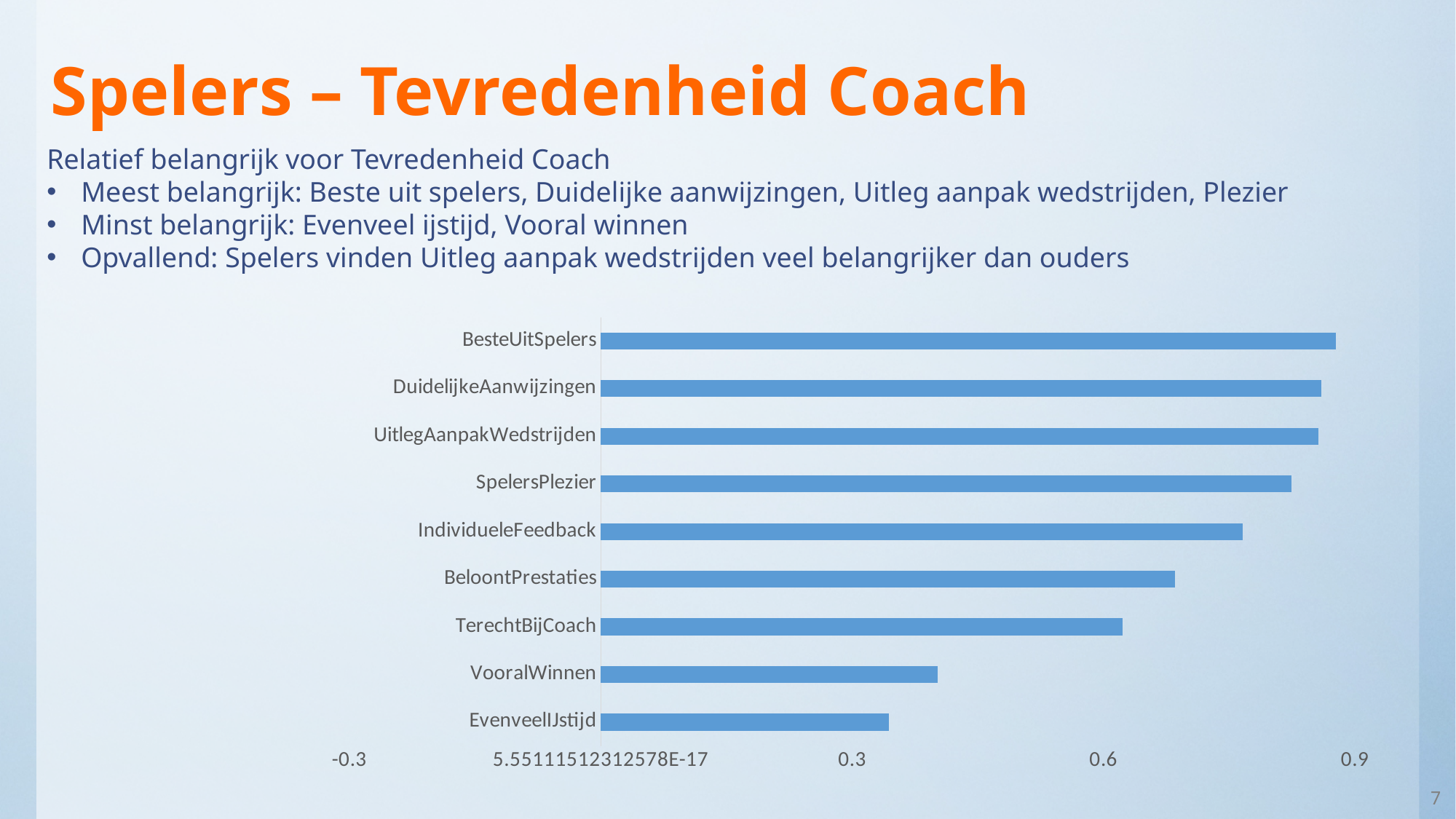
Is the value for BeloontPrestaties greater or less than 0.9? less Which category has the highest value in the bar chart? BesteUitSpelers Which category has the lowest value in the bar chart? EvenveelIJstijd Which is larger, the value for SpelersPlezier or the value for IndividueleFeedback? SpelersPlezier How many categories are plotted in the bar chart? 9 Is the value for EvenveelIJstijd greater or less than 0.3? greater Is the value for IndividueleFeedback greater or less than 0.6? greater What kind of chart is shown on the slide? bar chart What colour are the bars in the chart? blue Which is larger, the value for VooralWinnen or the value for TerechtBijCoach? TerechtBijCoach